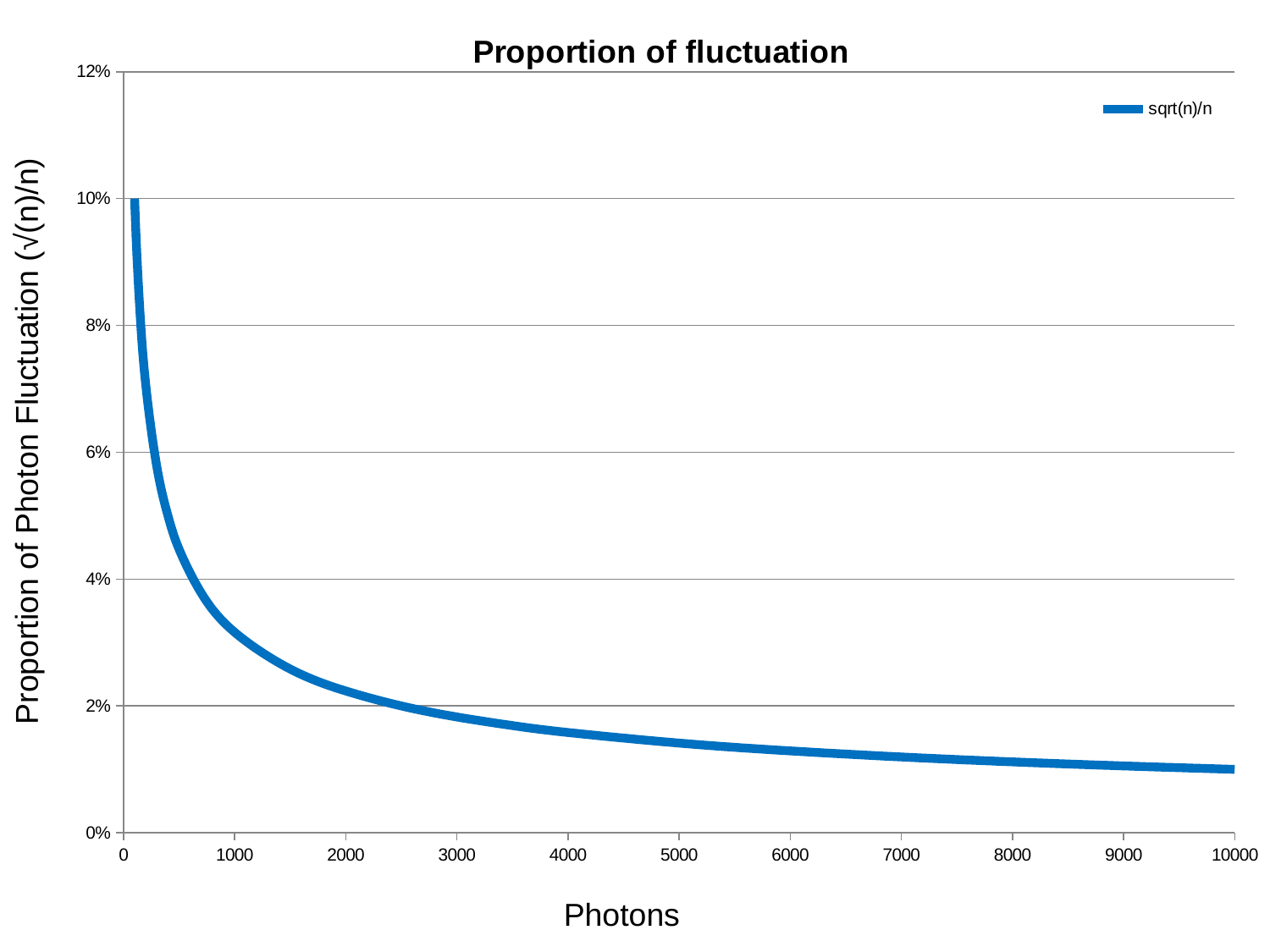
What kind of chart is shown on the slide? line chart Is the value for 1000 photons greater or less than 2%? greater What is the title of the chart? Proportion of fluctuation How many series does the legend list? 1 Is the value for 5000 photons greater or less than 2%? less What is the name of the series shown in the legend? sqrt(n)/n Does the plotted value rise or fall as the number of photons increases along the x axis? fall Is the value for 10000 photons greater or less than 2%? less Which has the larger value, 1000 photons or 9000 photons? 1000 photons What is the label of the x axis? Photons